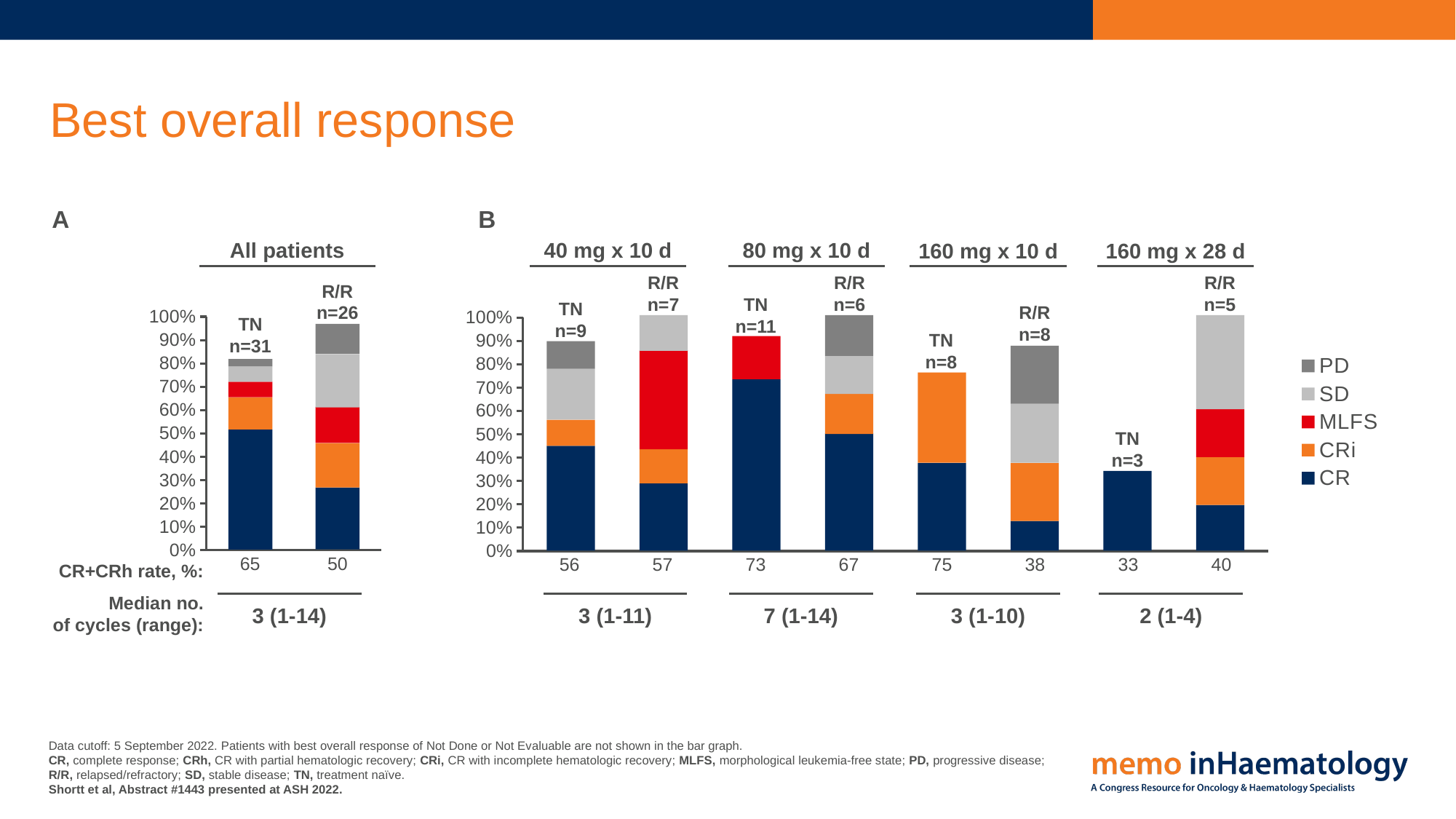
How many bars are shown in chart B? 8 How many series does the legend list? 5 In chart A (All patients), what is the CR+CRh rate (%) for the R/R group? 50 In chart B, which group has the highest CR+CRh rate? TN in 160 mg x 10 d In chart B, what is the median number of cycles (range) for the 80 mg x 10 d cohort? 7 (1-14) In chart A (All patients), what is the difference in CR+CRh rate between the TN and R/R groups? 15 In chart B, what is the CR+CRh rate (%) for the TN group in the 80 mg x 10 d cohort? 73 In chart B, in the 40 mg x 10 d cohort, which group has the higher CR+CRh rate, TN or R/R? R/R In chart A (All patients), what is the CR+CRh rate (%) for the TN group? 65 In chart B, which group has the lowest CR+CRh rate? TN in 160 mg x 28 d What kind of chart is chart A (All patients)? bar chart In chart B, is the CR segment for the TN group in the 80 mg x 10 d cohort greater or less than 60%? greater